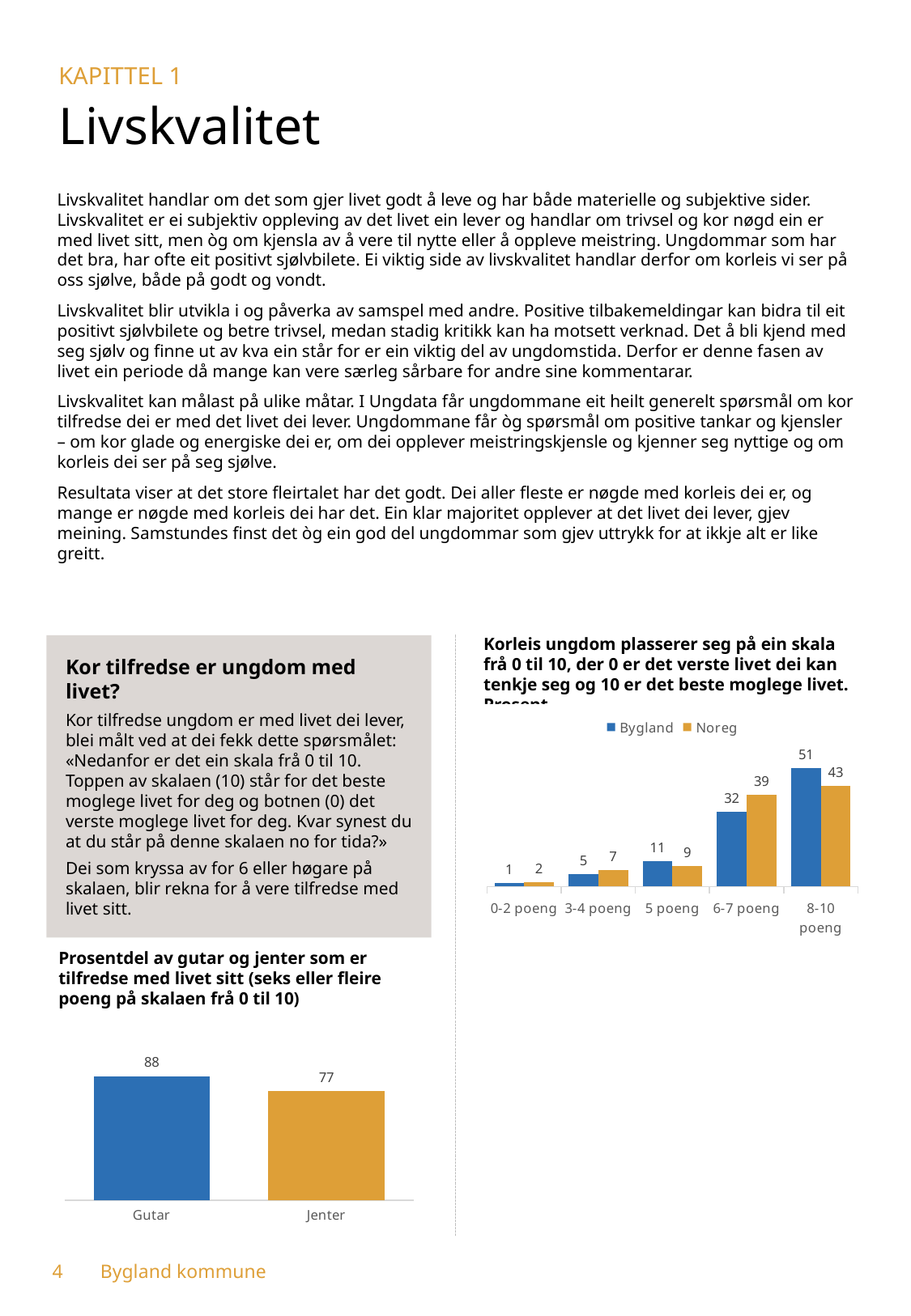
In the chart on the right (Korleis ungdom plasserer seg på ein skala frå 0 til 10), what is the value for Bygland in the 8-10 poeng category? 51 In the chart on the right (Korleis ungdom plasserer seg på ein skala frå 0 til 10), how many series does the legend list? 2 In the chart on the right (Korleis ungdom plasserer seg på ein skala frå 0 til 10), how many categories are shown on the x axis? 5 In the chart on the right (Korleis ungdom plasserer seg på ein skala frå 0 til 10), which category has the lowest value for Noreg? 0-2 poeng In the chart on the right (Korleis ungdom plasserer seg på ein skala frå 0 til 10), what is the value for Noreg in the 6-7 poeng category? 39 In the chart on the right (Korleis ungdom plasserer seg på ein skala frå 0 til 10), which category has the highest value for Bygland? 8-10 poeng What kind of chart is the chart at the bottom left (Prosentdel av gutar og jenter som er tilfredse med livet sitt)? bar chart In the chart on the right (Korleis ungdom plasserer seg på ein skala frå 0 til 10), what is the difference between Bygland and Noreg in the 8-10 poeng category? 8 In the chart on the right (Korleis ungdom plasserer seg på ein skala frå 0 til 10), which is larger in the 5 poeng category, Bygland or Noreg? Bygland In the chart on the right (Korleis ungdom plasserer seg på ein skala frå 0 til 10), do the Bygland values rise or fall from 0-2 poeng to 8-10 poeng? rise In the chart at the bottom left (Prosentdel av gutar og jenter som er tilfredse med livet sitt), what is the value for Gutar? 88 In the chart at the bottom left (Prosentdel av gutar og jenter som er tilfredse med livet sitt), what is the difference between Gutar and Jenter? 11